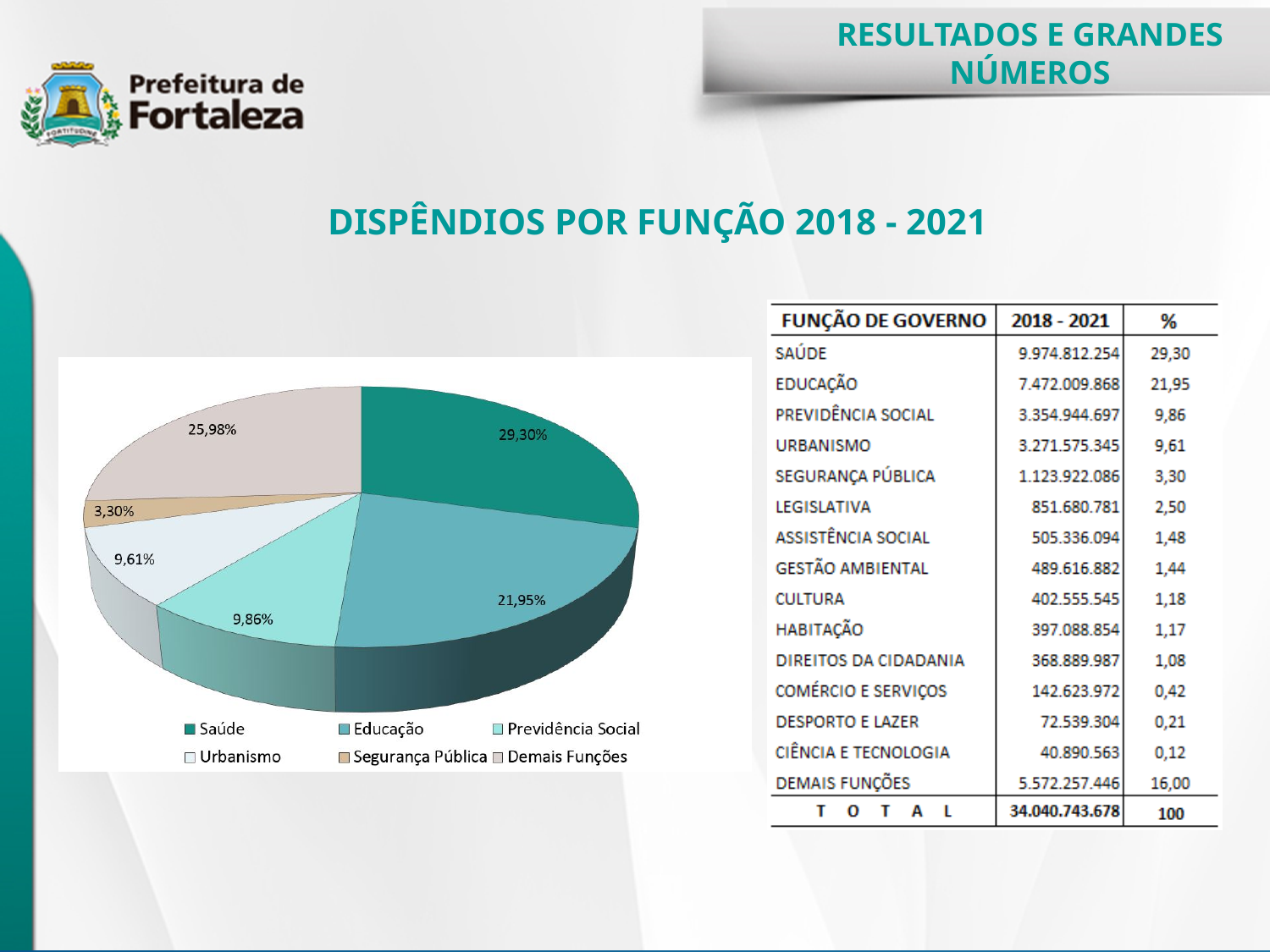
What is the share shown for Urbanismo in the pie chart? 9,61% How many slices does the pie chart have? 6 What is the difference in percentage points between the Saúde and Educação slices? 7,35 Which is larger in the pie chart, Educação or Demais Funções? Demais Funções What is the share shown for Saúde in the pie chart? 29,30% What is the share shown for Demais Funções in the pie chart? 25,98% What kind of chart is shown on the slide? Pie chart Which category has the largest slice in the pie chart? Saúde What is the share shown for Segurança Pública in the pie chart? 3,30% What is the share shown for Previdência Social in the pie chart? 9,86% Which category has the smallest slice in the pie chart? Segurança Pública What is the share shown for Educação in the pie chart? 21,95%